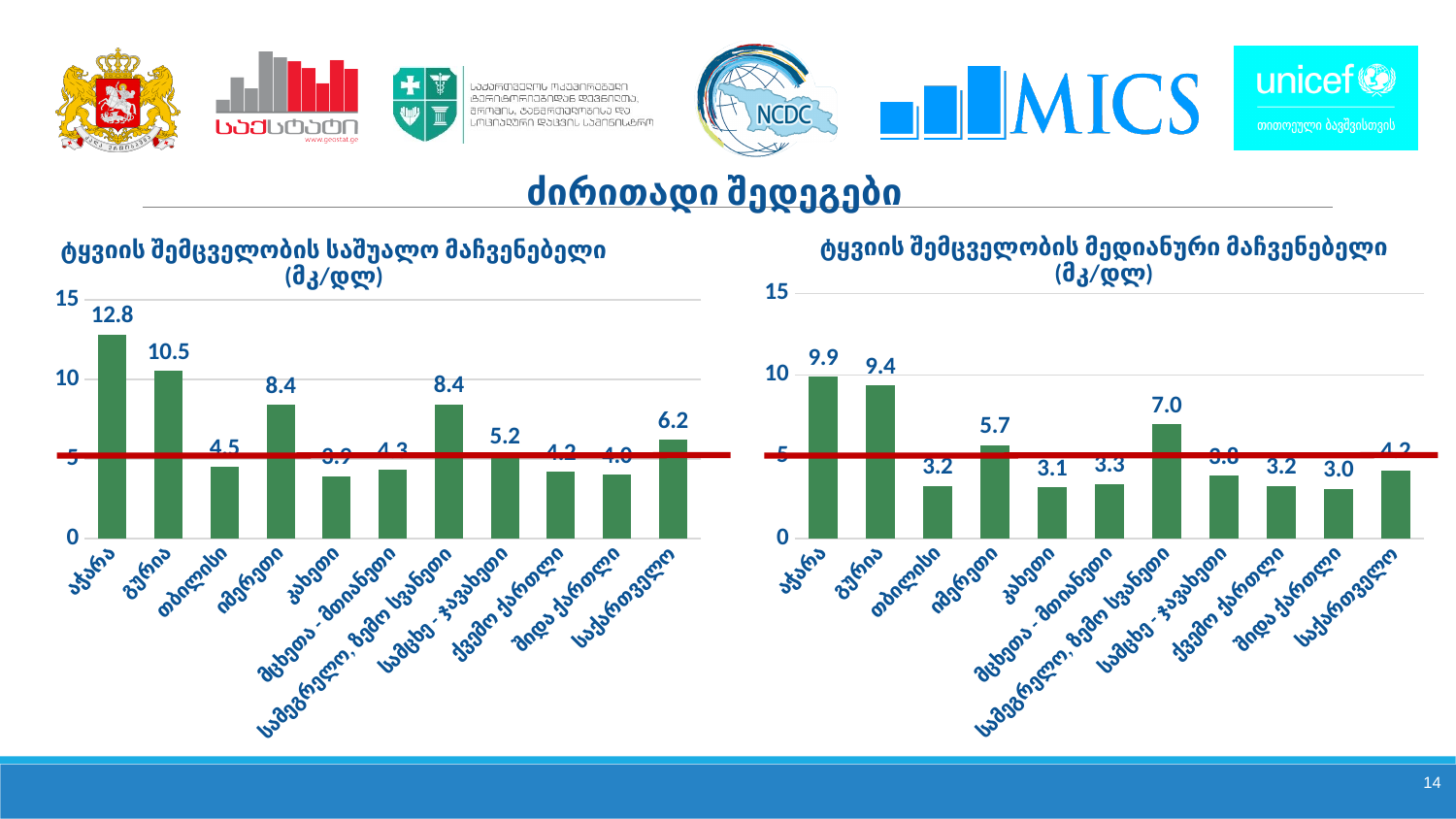
On the left chart (ტყვიის შემცველობის საშუალო მაჩვენებელი), which region has the highest value? აჭარა On the left chart (ტყვიის შემცველობის საშუალო მაჩვენებელი), what is the value for გურია? 10.5 What kind of chart is the right chart (ტყვიის შემცველობის მედიანური მაჩვენებელი)? Bar chart On the left chart (ტყვიის შემცველობის საშუალო მაჩვენებელი), what is the value for აჭარა? 12.8 On the right chart (ტყვიის შემცველობის მედიანური მაჩვენებელი), which region has the lowest value? შიდა ქართლი On the right chart (ტყვიის შემცველობის მედიანური მაჩვენებელი), what is the value for იმერეთი? 5.7 On the left chart (ტყვიის შემცველობის საშუალო მაჩვენებელი), what is the value for საქართველო? 6.2 On the right chart (ტყვიის შემცველობის მედიანური მაჩვენებელი), is the value for გურია greater or less than 5? greater On the right chart (ტყვიის შემცველობის მედიანური მაჩვენებელი), what is the value for აჭარა? 9.9 On the left chart (ტყვიის შემცველობის საშუალო მაჩვენებელი), what is the difference between the values for აჭარა and გურია? 2.3 On the right chart (ტყვიის შემცველობის მედიანური მაჩვენებელი), what is the value for სამეგრელო, ზემო სვანეთი? 7.0 How many categories are shown on the x axis of the left chart? 11